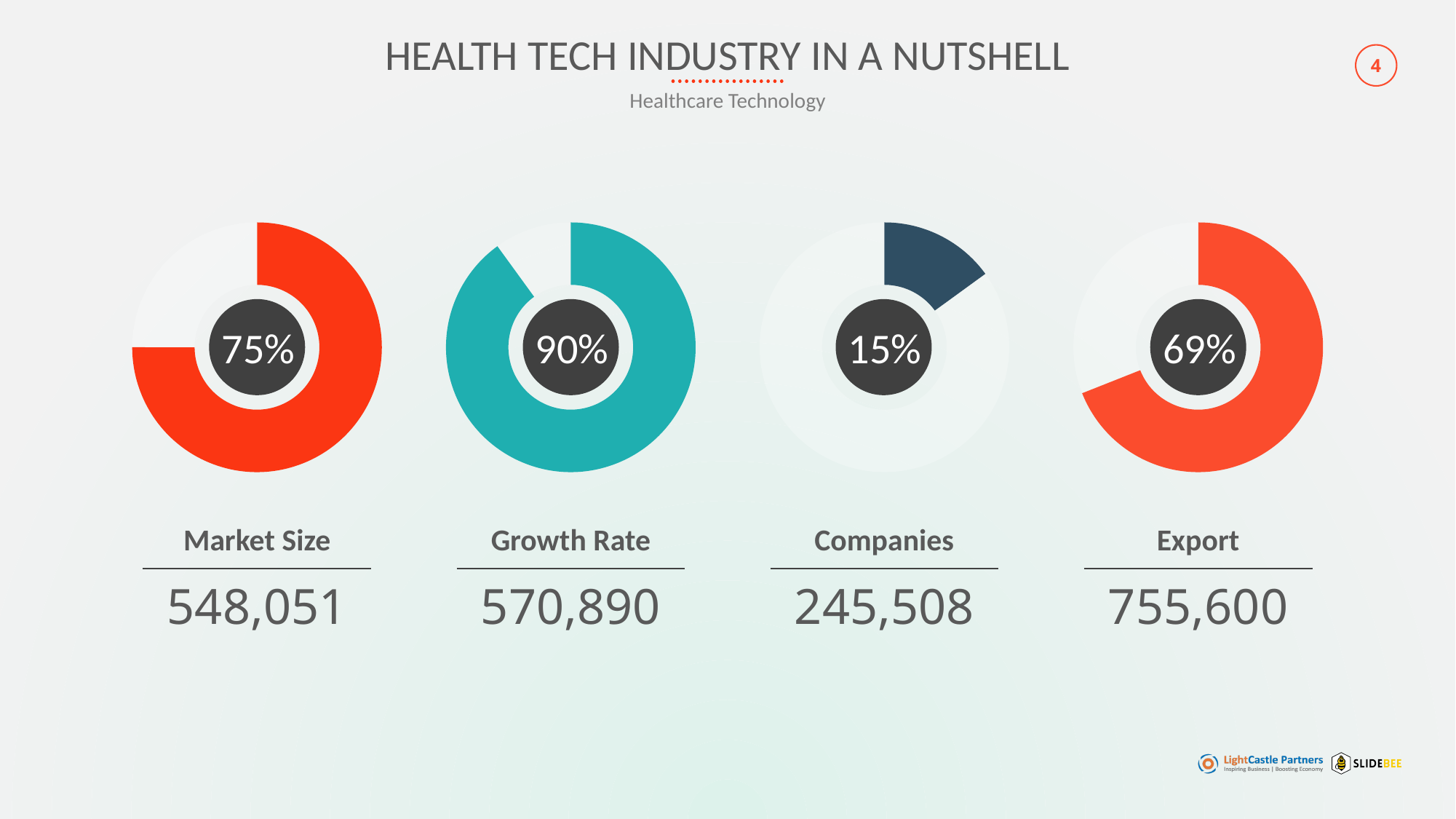
What percentage is shown in the Market Size donut chart? 75% What is the difference in percentage points between the Growth Rate donut and the Companies donut? 75 What type of chart is used for the Market Size figure? Donut chart What percentage is shown in the Companies donut chart? 15% What number is printed below the Export donut chart? 755,600 What percentage is shown in the Growth Rate donut chart? 90% What percentage is shown in the Export donut chart? 69% Which shows a larger percentage, the Market Size donut or the Export donut? Market Size Which of the four donut charts shows the highest percentage? Growth Rate Which of the four donut charts shows the lowest percentage? Companies How many donut charts are on the slide? 4 What colour is the filled portion of the Growth Rate donut chart? Teal